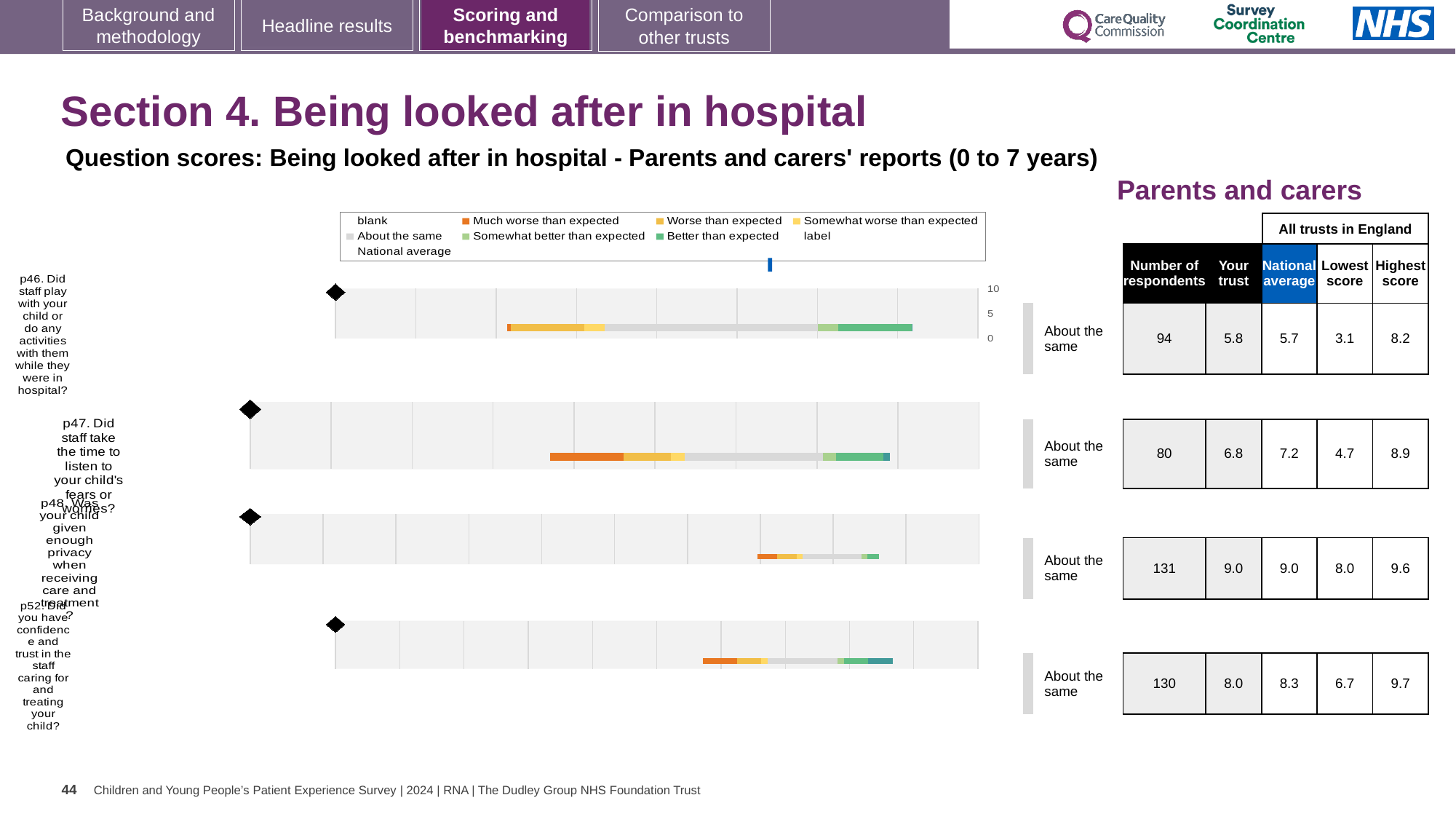
For p52, what is the highest score among all trusts in England? 9.7 What kind of chart is used to show the question scores on this slide? bar chart For p47, what is the difference between the highest score and the lowest score across all trusts in England? 4.2 For p52 (Did you have confidence and trust in the staff caring for and treating your child?), which is larger: the 'Your trust' score or the national average? National average How many respondents are shown for p48 (Was your child given enough privacy when receiving care and treatment?)? 131 Which question has the highest 'Your trust' score on this slide? p48 For the p47 chart (Did staff take the time to listen to your child's fears or worries?), what is the national average score? 7.2 Which question has the lowest 'Your trust' score on this slide? p46 What benchmark category is shown next to the p46 chart? About the same How many question bar charts are shown on the slide? 4 In the chart legend, what colour represents 'Much worse than expected'? orange For the p46 chart (Did staff play with your child or do any activities with them while they were in hospital?), what is the 'Your trust' score shown in the table? 5.8